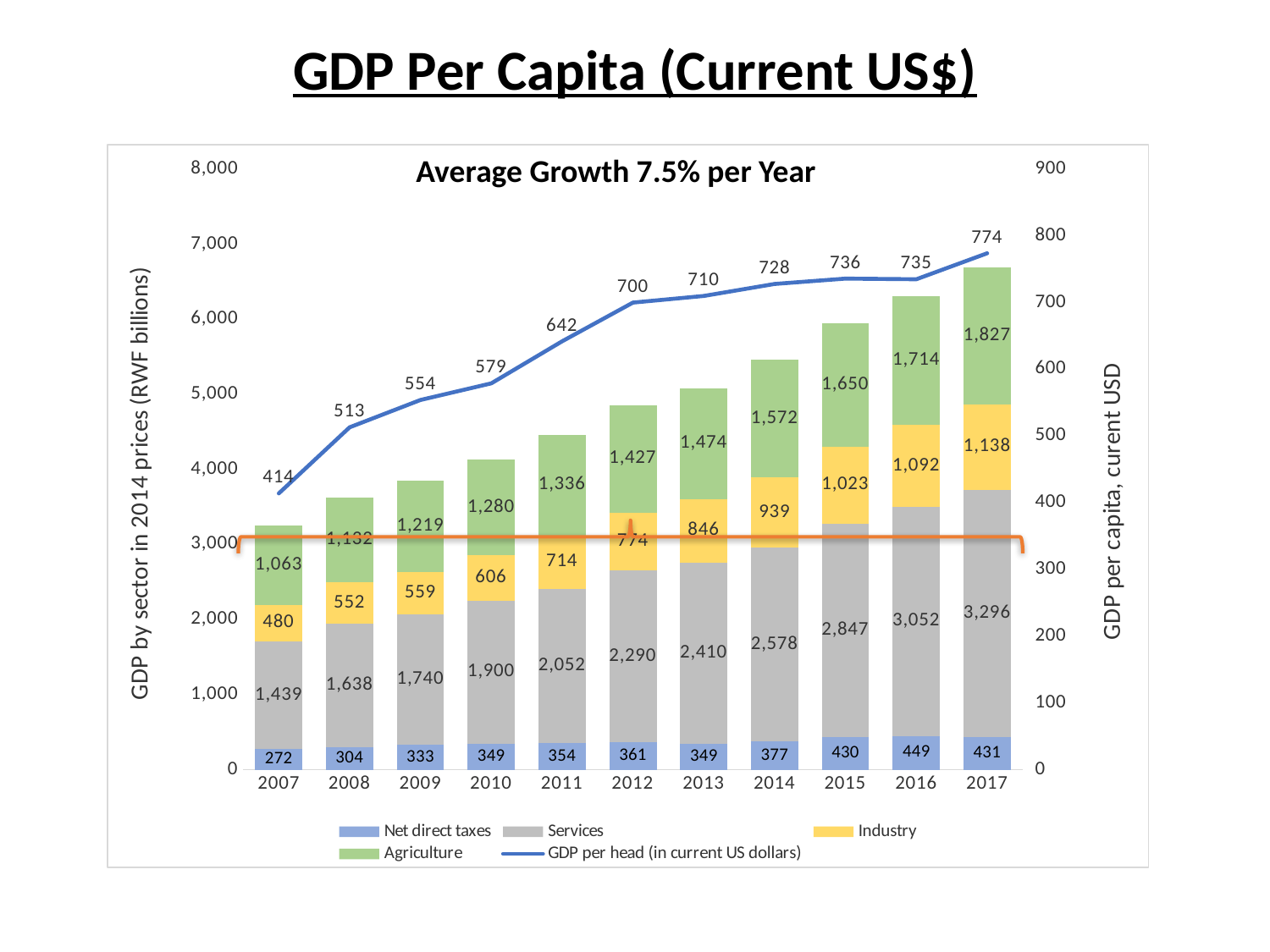
Which is larger in 2016, the Services value or the Industry value? Services What is the total of the stacked bar for 2007? 3,254 In which year is GDP per head (in current US dollars) highest? 2017 How many years are shown on the x axis? 11 What is the GDP per head (in current US dollars) value shown for 2014? 728 By how much did the Agriculture value increase from 2007 to 2017? 764 What is the difference between GDP per head in 2017 and in 2007? 360 What is the Net direct taxes value for 2016? 449 In which year is the Net direct taxes value lowest? 2007 What is the Services value for 2015? 2,847 Is the total height of the stacked bar for 2017 greater or less than 6,000? greater How many series does the legend list? 5